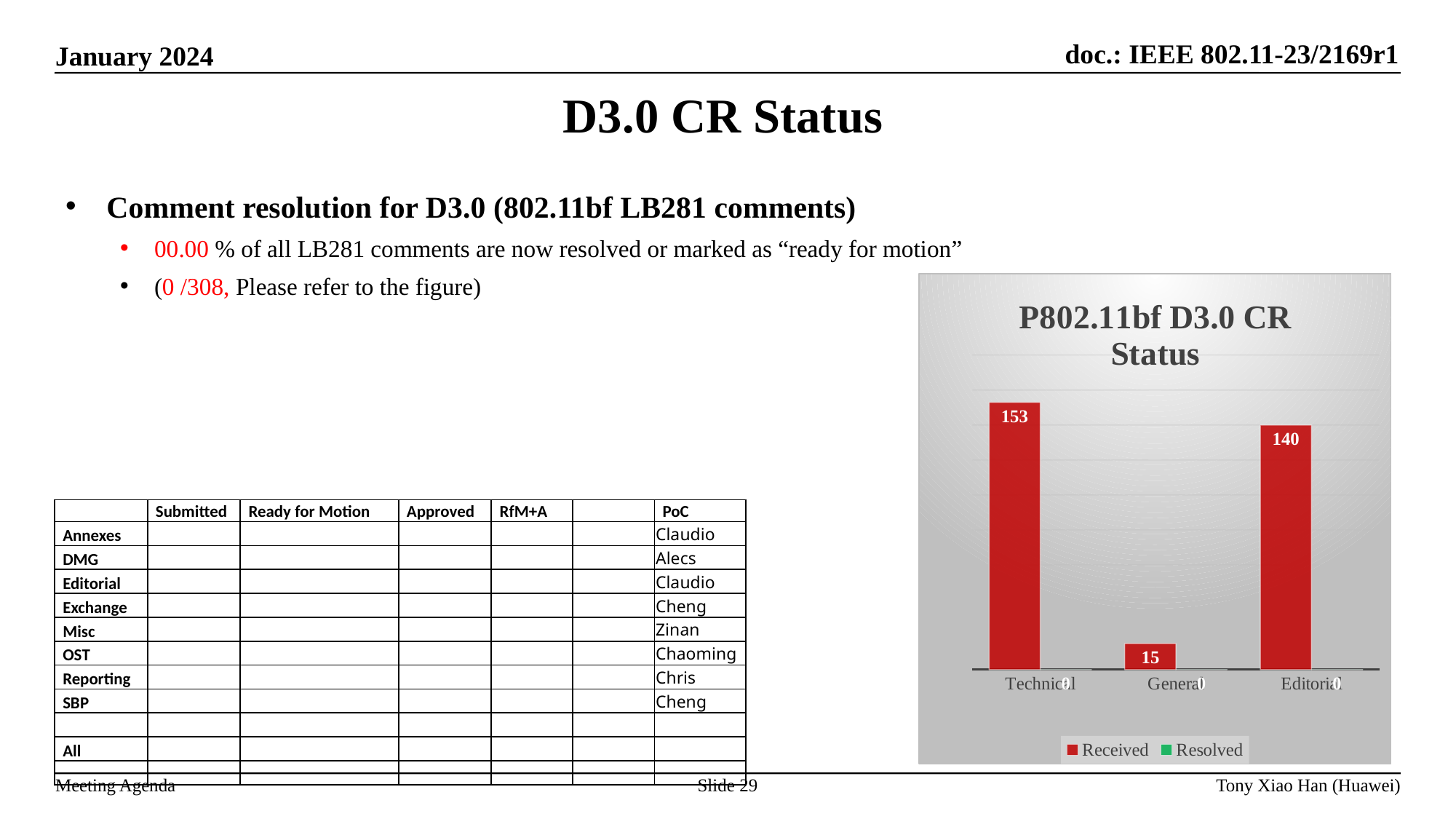
How many series does the chart legend list? 2 What is the Received value for General? 15 What is the difference between the Received values for Technical and Editorial? 13 What is the Received value for Editorial? 140 Which category has the highest Received value? Technical How many categories are shown on the x axis of the chart? 3 What is the difference between the Received values for Editorial and General? 125 What kind of chart is shown on the slide? Bar chart What is the Received value for Technical? 153 Which has a larger Received value, Technical or Editorial? Technical What is the title of the chart? P802.11bf D3.0 CR Status Which category has the lowest Received value? General